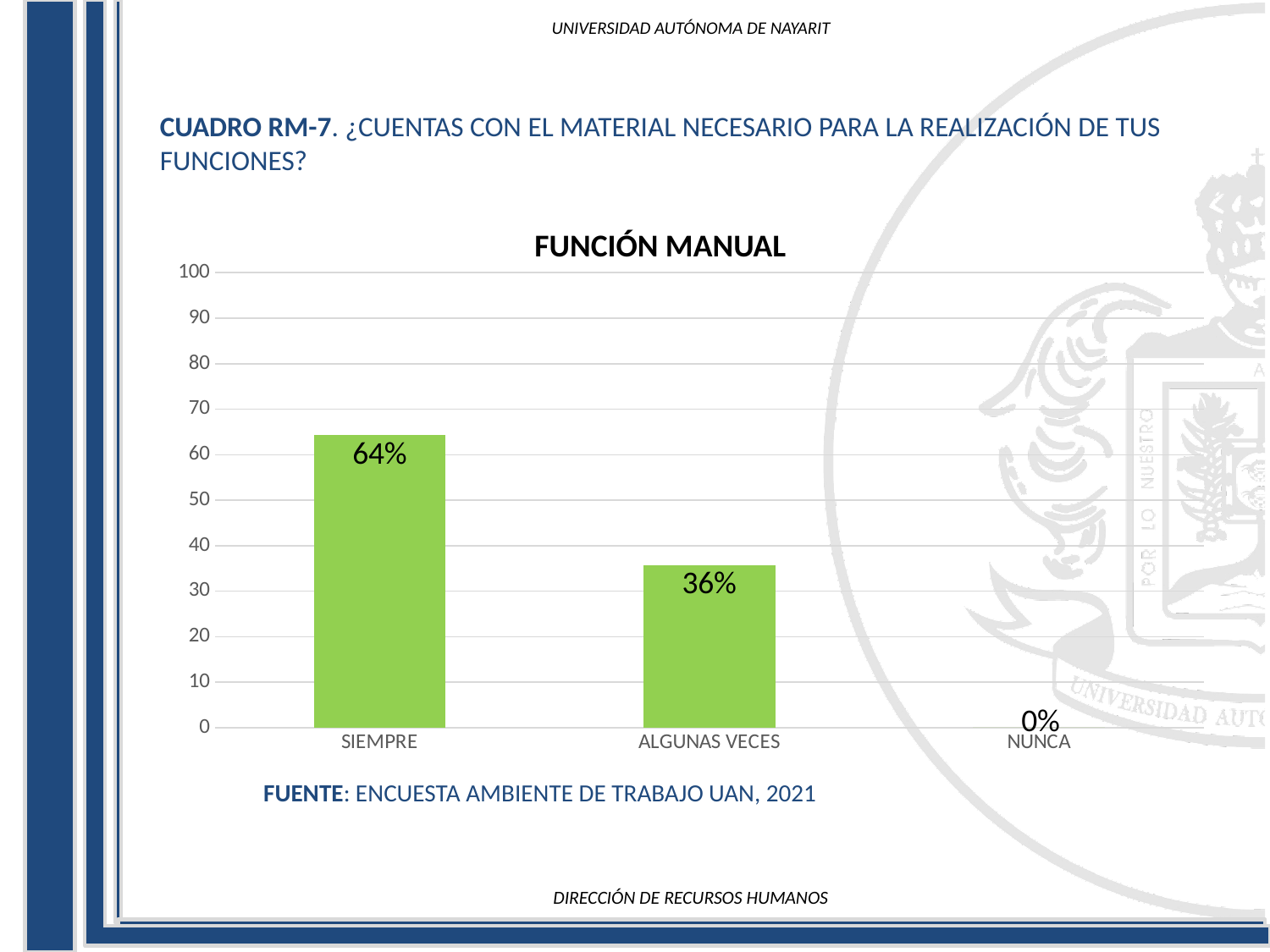
What is the value for NUNCA? 0% Is the value for ALGUNAS VECES greater or less than 40? less What is the title of the chart? FUNCIÓN MANUAL What is the value for SIEMPRE? 64% How many categories are shown on the x axis? 3 What kind of chart is shown? bar chart Which category has the highest value? SIEMPRE Which is larger, the value for SIEMPRE or the value for ALGUNAS VECES? SIEMPRE Do the values rise or fall from left to right along the x axis? fall What is the difference between the values for SIEMPRE and ALGUNAS VECES? 28% What is the value for ALGUNAS VECES? 36% Which category has the lowest value? NUNCA